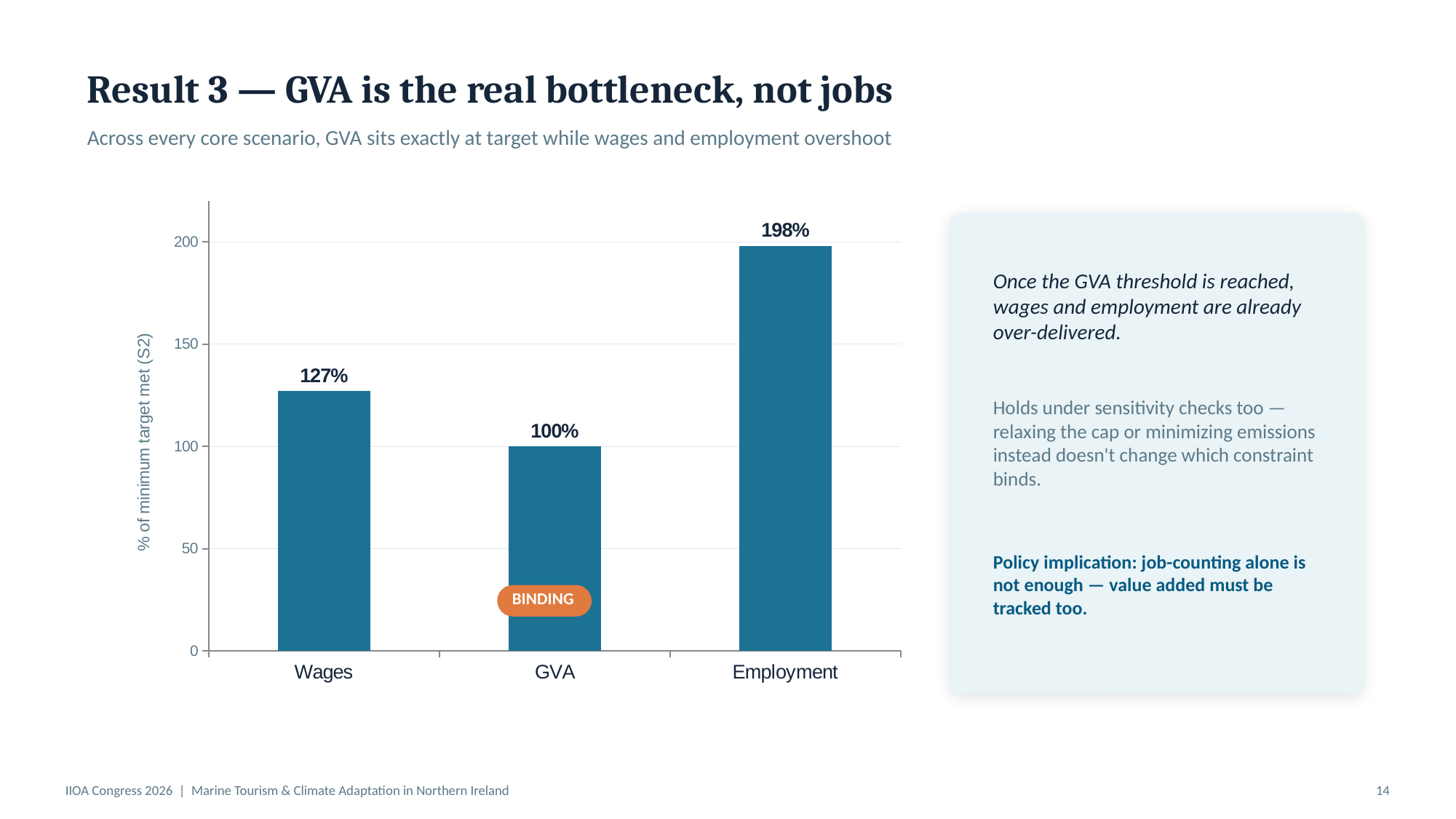
Which category has the highest value? Employment How many categories are shown on the x axis? 3 What is the difference between the values for Employment and Wages? 71% What kind of chart is shown on the slide? bar chart What is the value for Wages? 127% What is the value for GVA? 100% What is the difference between the values for Wages and GVA? 27% What is the value for Employment? 198% Which category has the lowest value? GVA What is the label on the y axis of the chart? % of minimum target met (S2) Is the value for Employment greater or less than 150? greater Which is larger, the value for Wages or the value for GVA? Wages